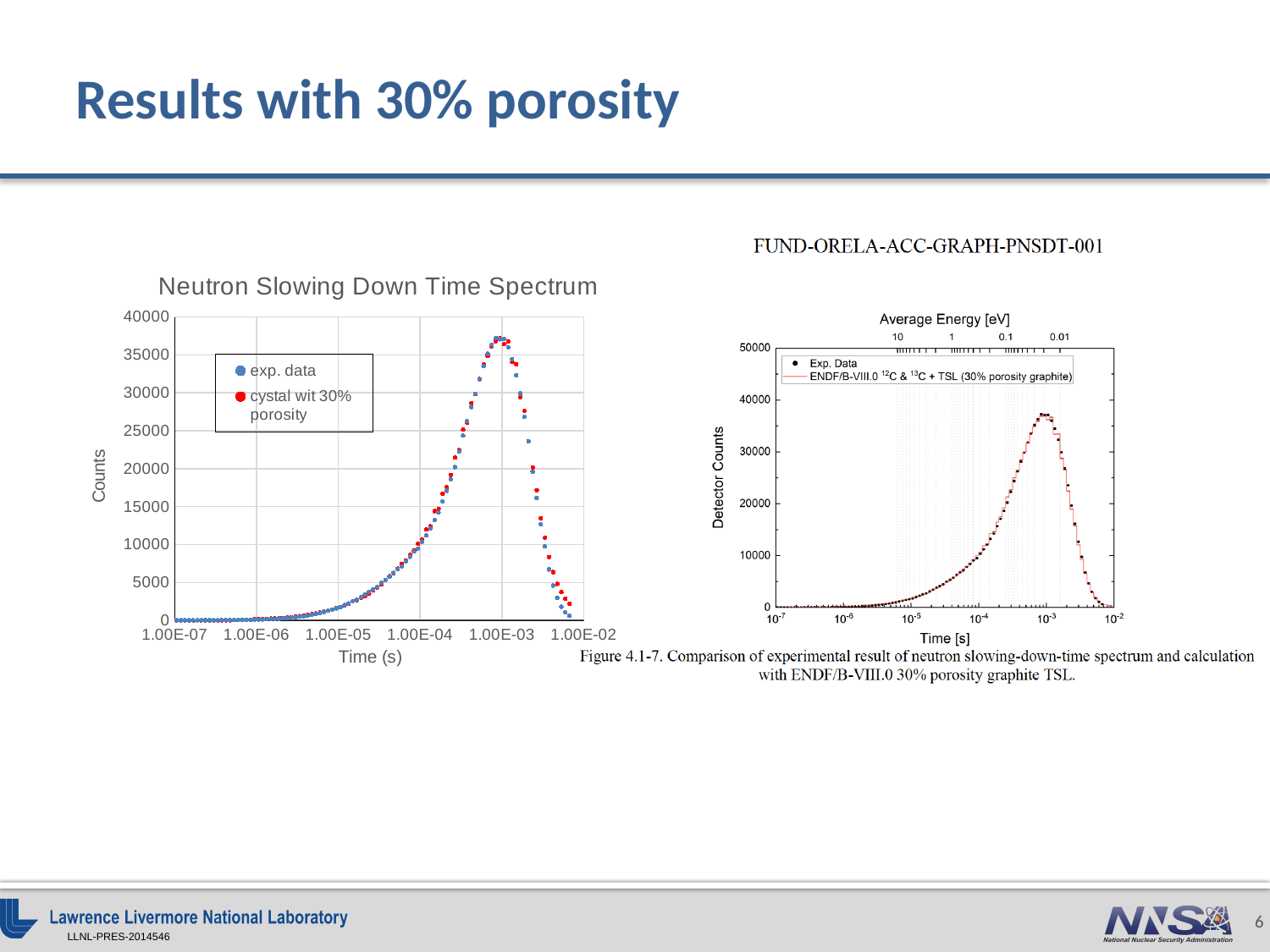
In the left chart "Neutron Slowing Down Time Spectrum", what is the label of the y axis? Counts In the right chart "FUND-ORELA-ACC-GRAPH-PNSDT-001", is the peak of the Exp. Data series greater or less than 30000? greater What kind of chart is the left chart titled "Neutron Slowing Down Time Spectrum"? scatter chart In the left chart "Neutron Slowing Down Time Spectrum", is the peak value of the exp. data series greater or less than 35000? greater How many series does the legend of the right chart "FUND-ORELA-ACC-GRAPH-PNSDT-001" list? 2 In the left chart "Neutron Slowing Down Time Spectrum", is the exp. data value at 1.00E-05 s greater or less than 5000? less In the left chart "Neutron Slowing Down Time Spectrum", do the counts rise or fall as time increases from 1.00E-03 to 1.00E-02 s? fall In the left chart "Neutron Slowing Down Time Spectrum", what is the label of the x axis? Time (s) In the left chart "Neutron Slowing Down Time Spectrum", do the counts rise or fall as time increases from 1.00E-05 to 1.00E-04 s? rise In the right chart "FUND-ORELA-ACC-GRAPH-PNSDT-001", what is the label of the y axis? Detector Counts How many series does the legend of the left chart "Neutron Slowing Down Time Spectrum" list? 2